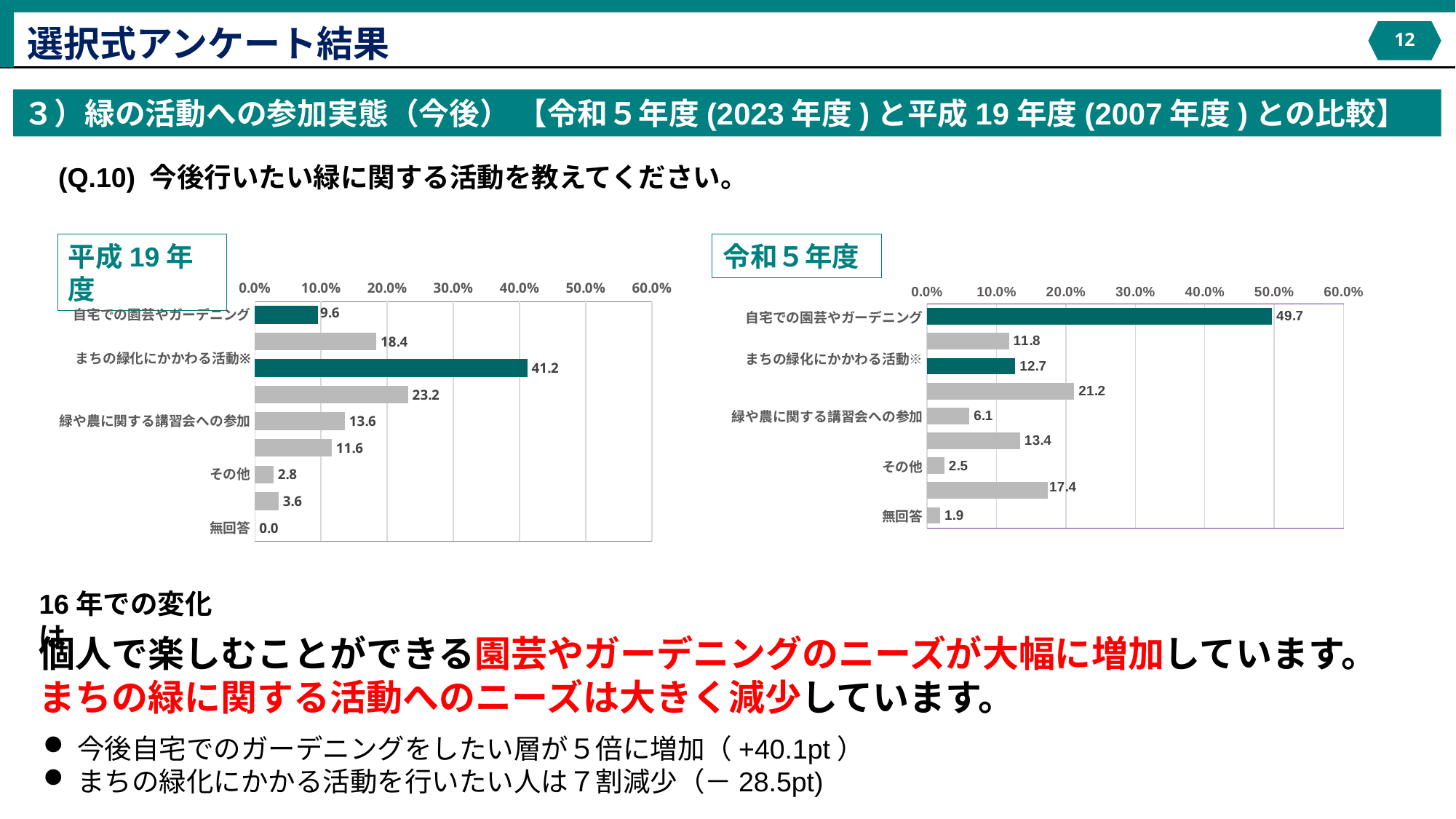
In the 令和5年度 chart, which is larger: その他 or 無回答? その他 In the 令和5年度 chart, which labeled category has the highest value? 自宅での園芸やガーデニング In the 平成19年度 chart, what is the value for まちの緑化にかかわる活動※? 41.2 What type of chart is the 令和5年度 chart? bar chart What is the difference between the 平成19年度 and 令和5年度 values for まちの緑化にかかわる活動※? 28.5 In the 平成19年度 chart, which labeled category has the highest value? まちの緑化にかかわる活動※ How many bars are plotted in the 平成19年度 chart? 9 In the 令和5年度 chart, what is the value for 緑や農に関する講習会への参加? 6.1 In the 平成19年度 chart, what is the value for 自宅での園芸やガーデニング? 9.6 In the 令和5年度 chart, what is the value for 自宅での園芸やガーデニング? 49.7 What is the difference between the 令和5年度 and 平成19年度 values for 自宅での園芸やガーデニング? 40.1 In the 平成19年度 chart, which labeled category has the lowest value? 無回答